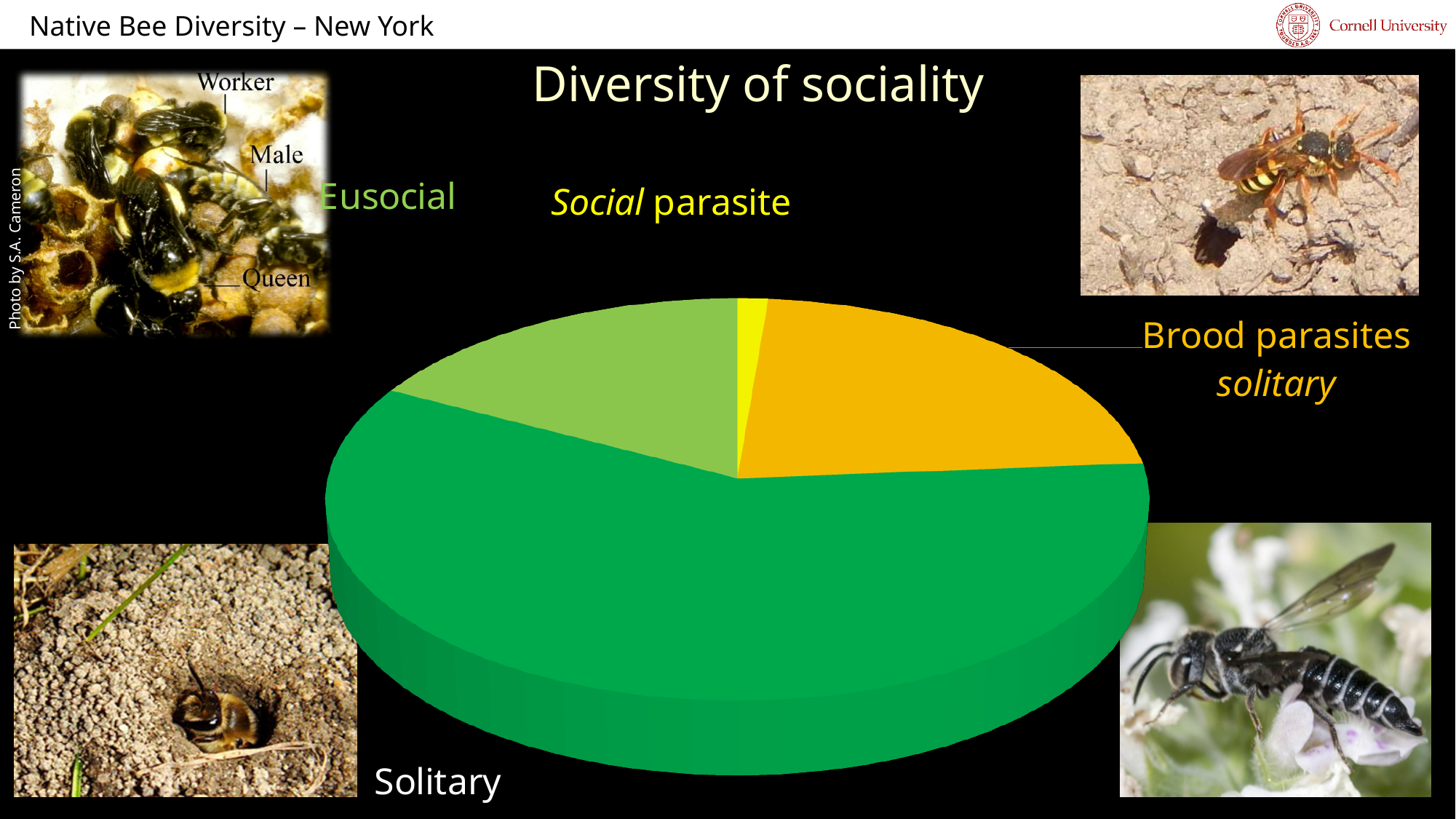
How many slices does the pie chart have? 4 Which slice is larger, Solitary or Brood parasites (solitary)? Solitary What is the title of the chart? Diversity of sociality Which slice is larger, Brood parasites (solitary) or Social parasite? Brood parasites (solitary) What kind of chart is shown on the slide? Pie chart Which category has the largest slice of the pie? Solitary Does the Solitary slice make up more or less than half of the pie? More Which category has the smallest slice of the pie? Social parasite What colour is the Solitary slice of the pie? Dark green